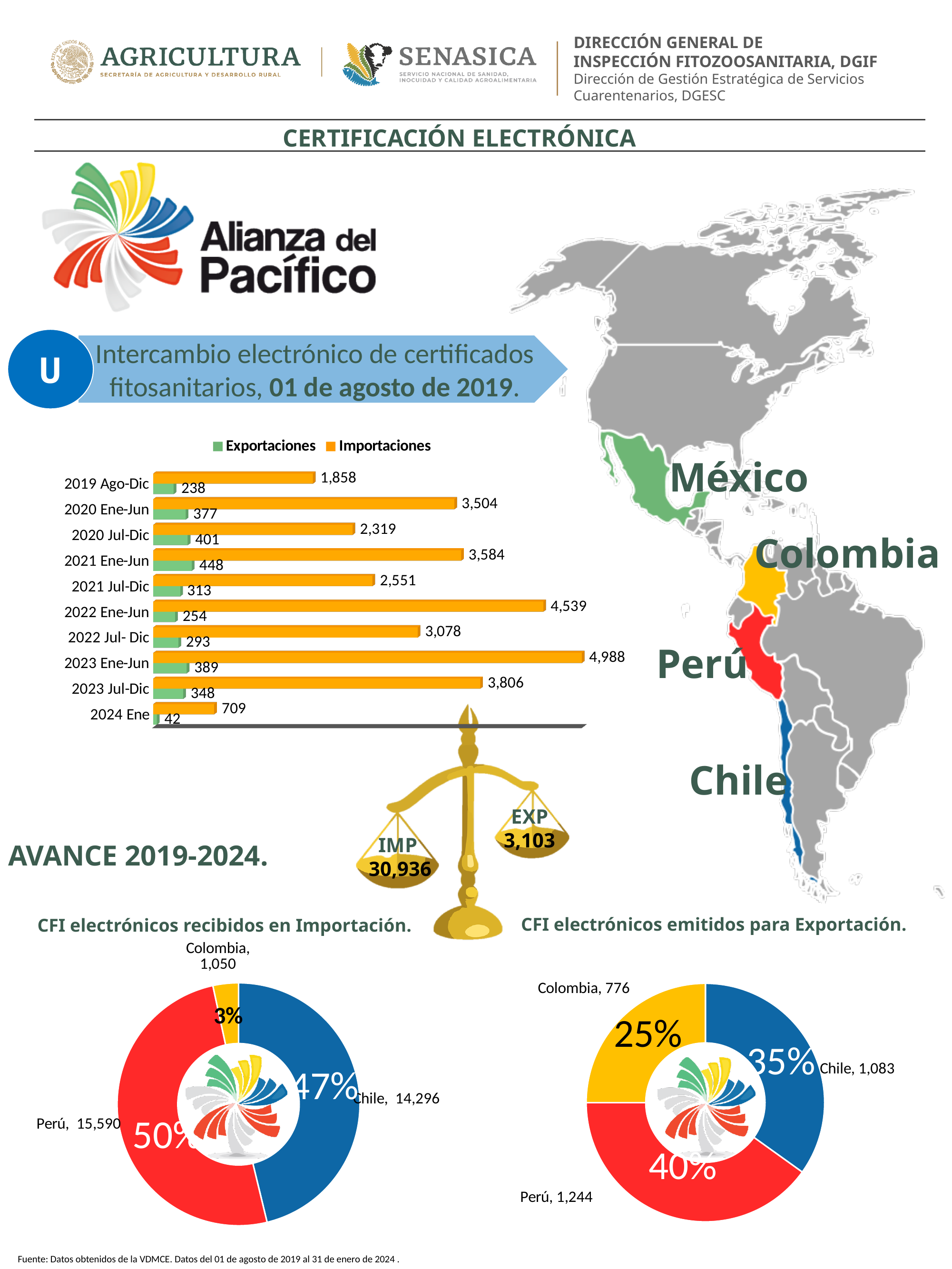
In the bar chart of Exportaciones and Importaciones by period, how many periods are shown? 10 In the chart 'CFI electrónicos emitidos para Exportación', what is the difference between Chile and Colombia? 307 In the bar chart of Exportaciones and Importaciones by period, what is the Importaciones value for 2022 Ene-Jun? 4,539 In the bar chart of Exportaciones and Importaciones by period, what is the Exportaciones value for 2021 Ene-Jun? 448 In the bar chart of Exportaciones and Importaciones by period, how many series does the legend list? 2 In the bar chart of Exportaciones and Importaciones by period, what is the difference between Importaciones and Exportaciones for 2019 Ago-Dic? 1,620 In the chart 'CFI electrónicos recibidos en Importación', what share does Colombia have? 3% In the chart 'CFI electrónicos emitidos para Exportación', which country has the largest value? Perú In the bar chart of Exportaciones and Importaciones by period, which period has the lowest Exportaciones value? 2024 Ene In the chart 'CFI electrónicos recibidos en Importación', what is the value for Perú? 15,590 What type of chart shows the Exportaciones and Importaciones by period? Bar chart In the bar chart of Exportaciones and Importaciones by period, which period has the highest Importaciones value? 2023 Ene-Jun